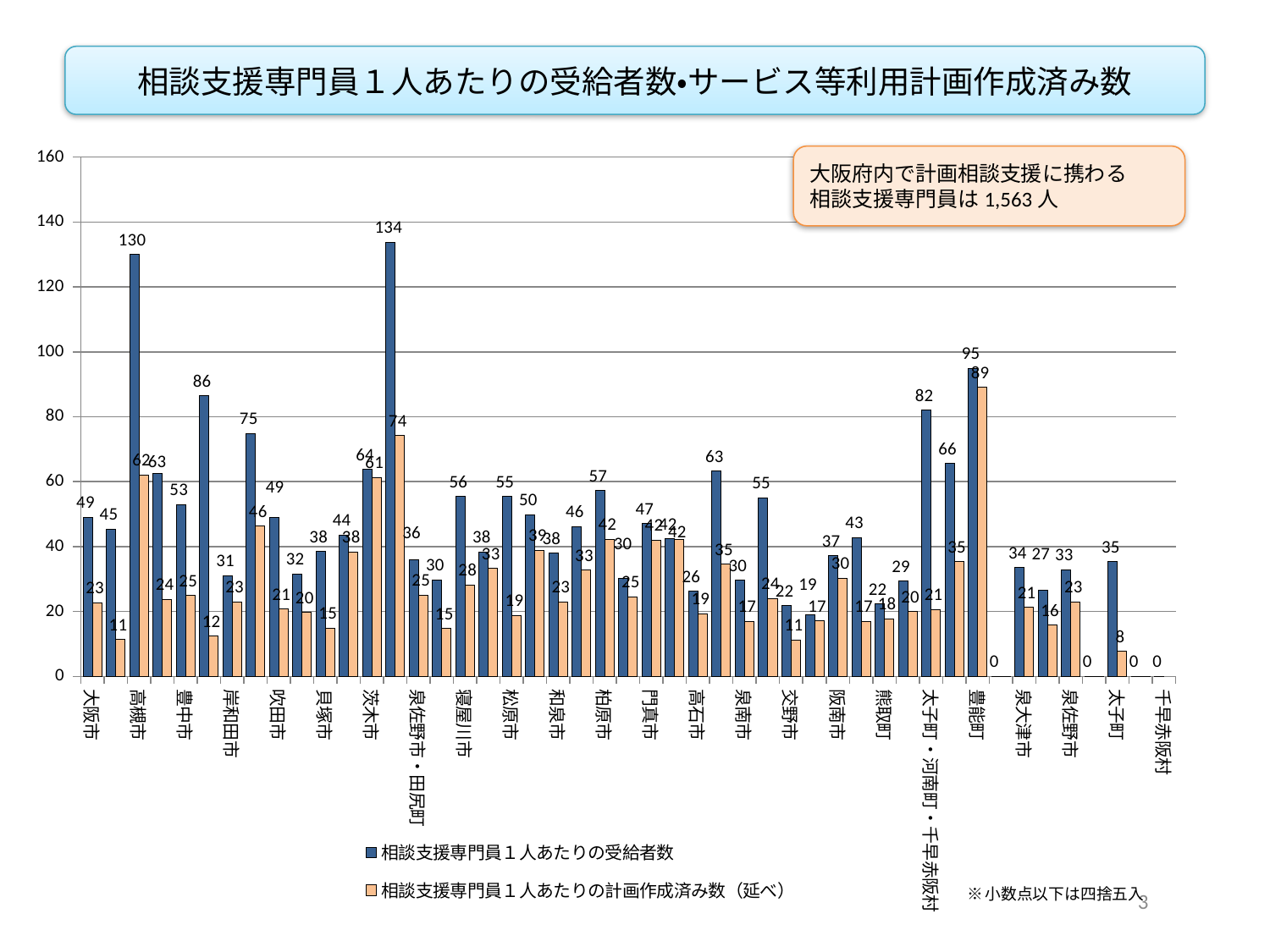
Which has a larger 相談支援専門員１人あたりの受給者数 value, 高槻市 or 大阪市? 高槻市 What is the 相談支援専門員１人あたりの計画作成済み数（延べ） value for 大阪市? 23 What is the 相談支援専門員１人あたりの受給者数 value for 豊能町? 95 What is the title of the chart? 相談支援専門員１人あたりの受給者数•サービス等利用計画作成済み数 Is the 相談支援専門員１人あたりの受給者数 value for 高槻市 greater or less than 100? greater What is the highest value shown for the 相談支援専門員１人あたりの受給者数 series? 134 What is the difference between the 受給者数 value (95) and the 計画作成済み数 value (89) for 豊能町? 6 What is the 相談支援専門員１人あたりの計画作成済み数（延べ） value for 豊能町? 89 What is the 相談支援専門員１人あたりの受給者数 value for 高槻市? 130 How many series does the legend list? 2 What kind of chart is shown on the slide? bar chart What is the 相談支援専門員１人あたりの受給者数 value for 大阪市? 49